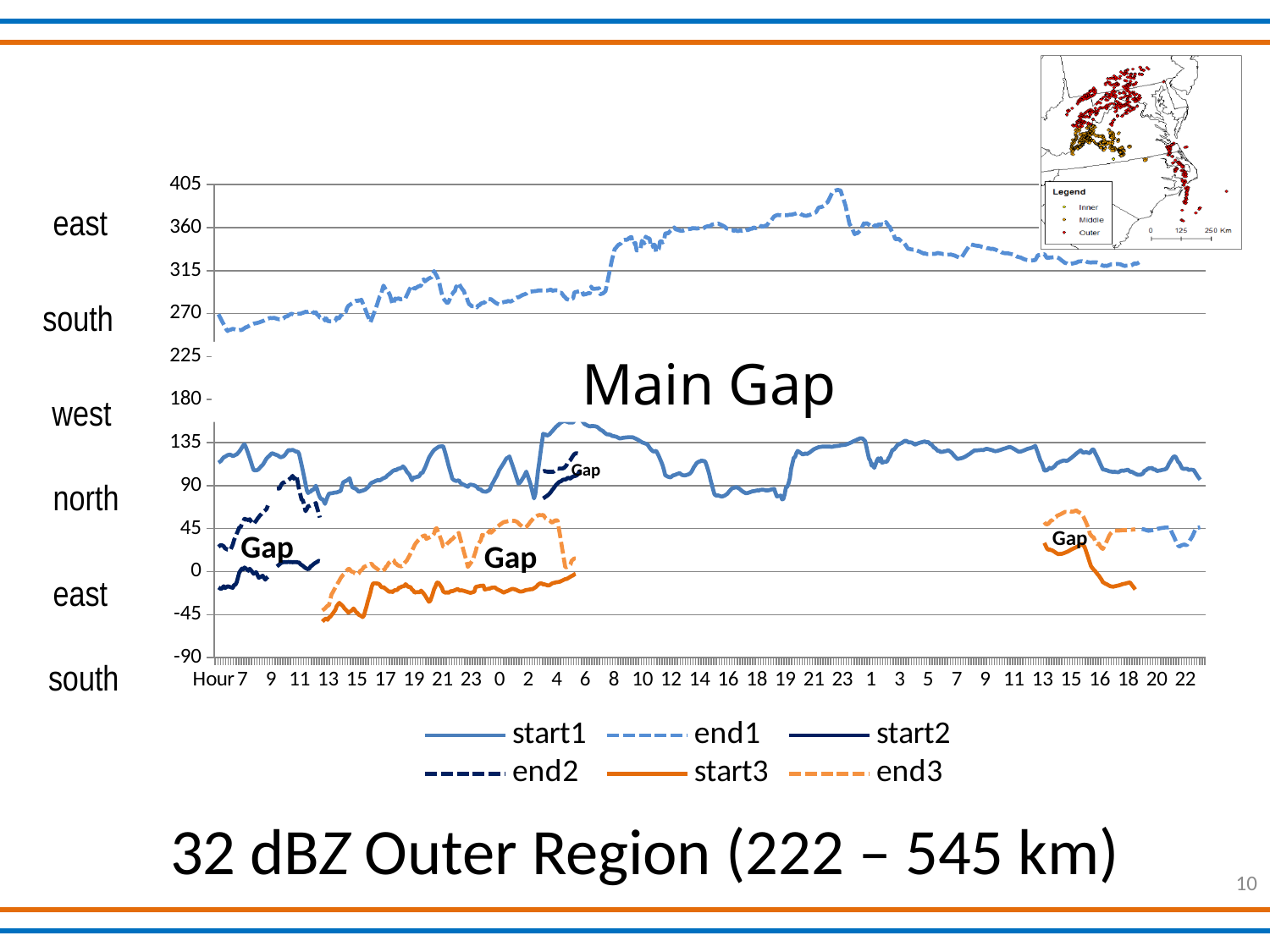
How many series does the legend list? 6 Is the peak value of the start1 series greater or less than 180? less What are the series names listed in the legend? start1, end1, start2, end2, start3, end3 What is the highest value shown on the y axis? 405 Does the end1 series generally rise or fall from the start of the x axis to its peak near hour 23 of the second day? rise Is the lowest value of the start3 series greater or less than 0? less Which series reaches the highest values on the chart? end1 Which series reaches higher values overall, end1 or start1? end1 Which series reaches the lowest values on the chart? start3 Is the peak value of the end1 series greater or less than 360? greater What kind of chart is shown on the slide? line chart